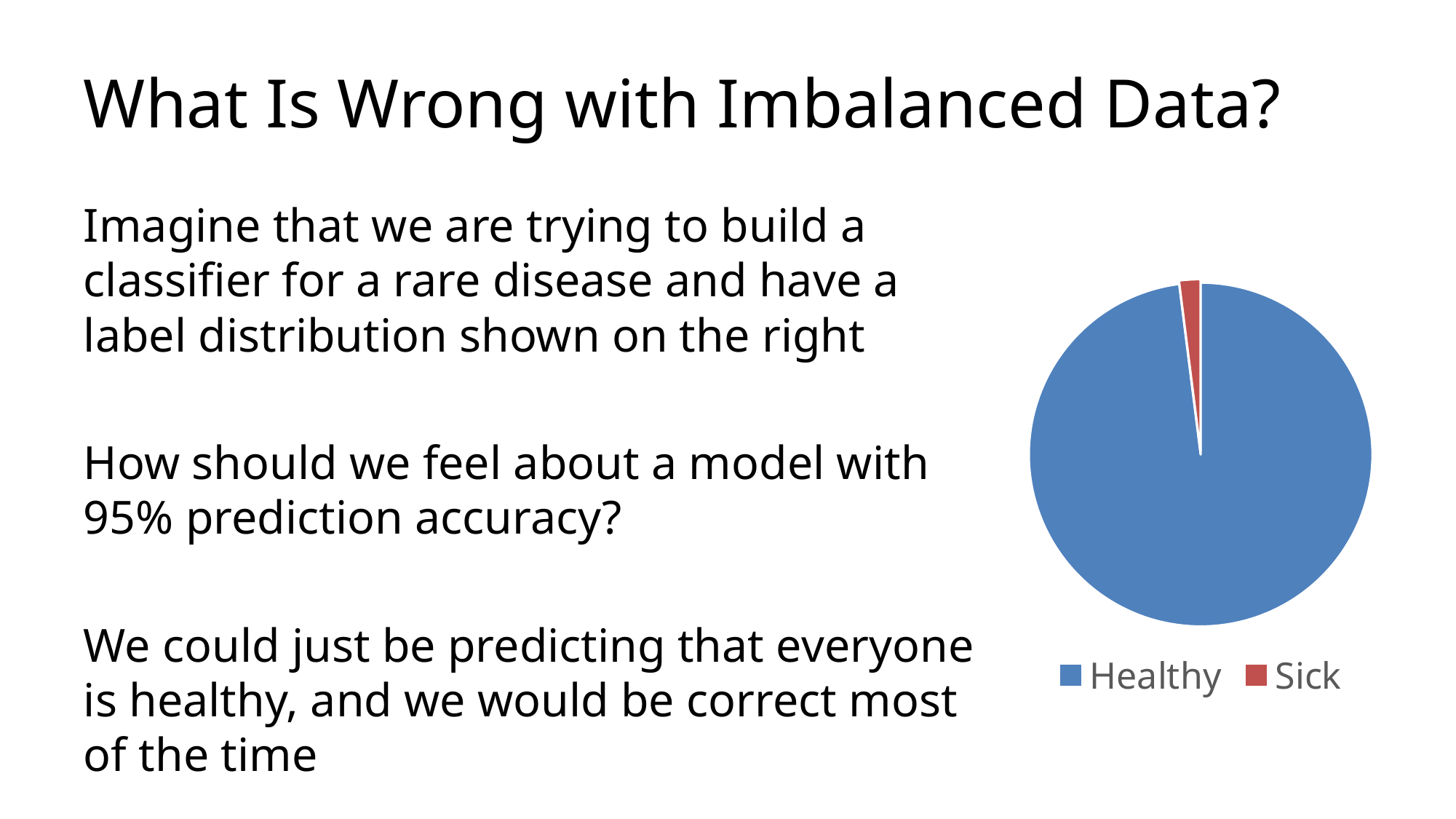
What kind of chart is shown on the slide? pie chart How many categories does the pie chart show? 2 What colour is the Sick slice in the pie chart? red What are the two legend entries of the pie chart? Healthy, Sick Which category has the largest slice in the pie chart? Healthy Which slice is larger in the pie chart, Healthy or Sick? Healthy Which category has the smallest slice in the pie chart? Sick